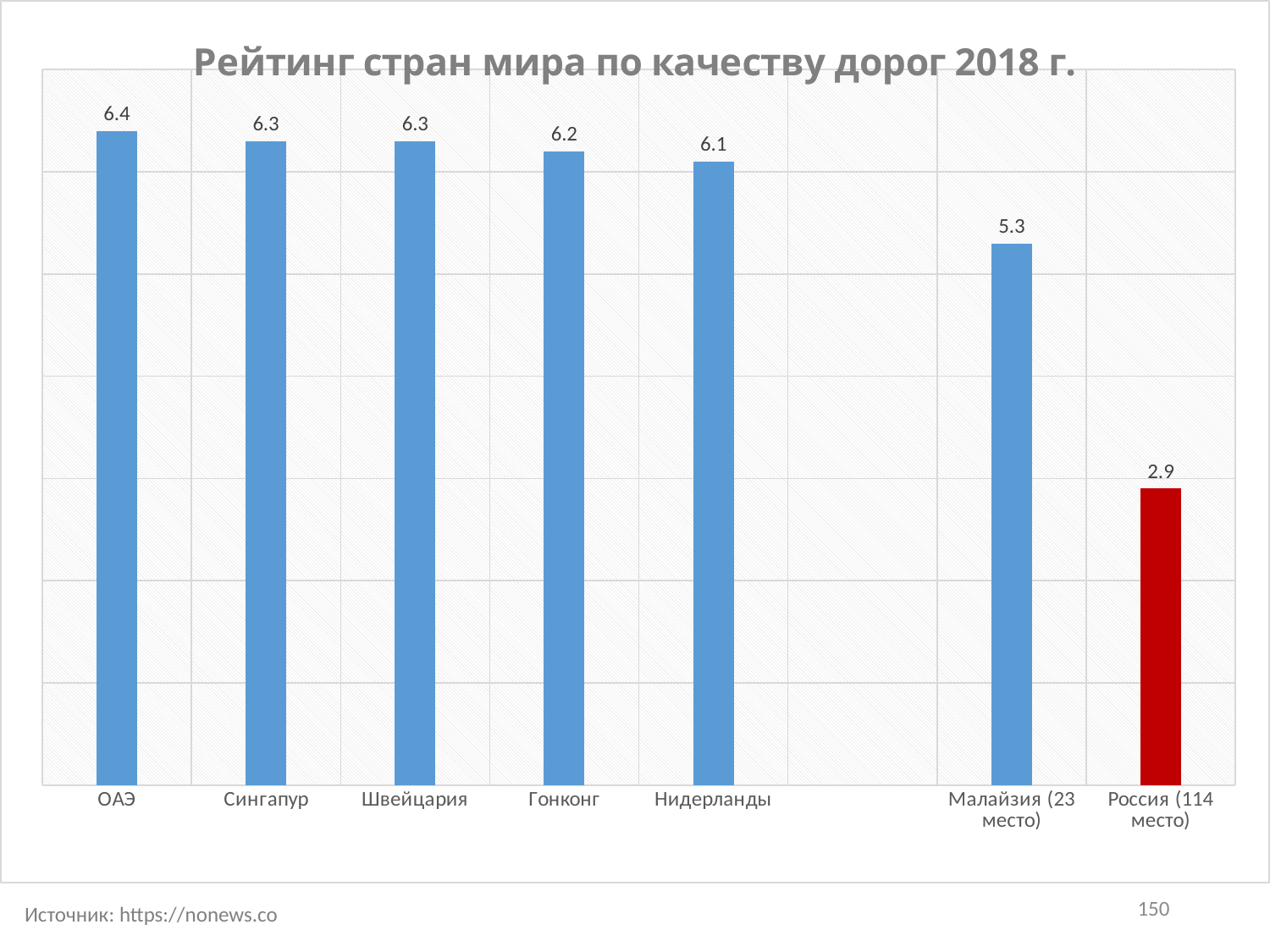
Which is larger, the value for Гонконг or the value for Малайзия (23 место)? Гонконг What is the value for Россия (114 место)? 2.9 What is the difference between the values for ОАЭ and Россия (114 место)? 3.5 What is the value for ОАЭ? 6.4 Which bar is coloured red? Россия (114 место) What kind of chart is this? Bar chart Which country has the highest value? ОАЭ How many countries are shown in the chart? 7 What is the difference between the values for Малайзия (23 место) and Россия (114 место)? 2.4 What is the value for Нидерланды? 6.1 What is the value for Малайзия (23 место)? 5.3 Which country has the lowest value? Россия (114 место)